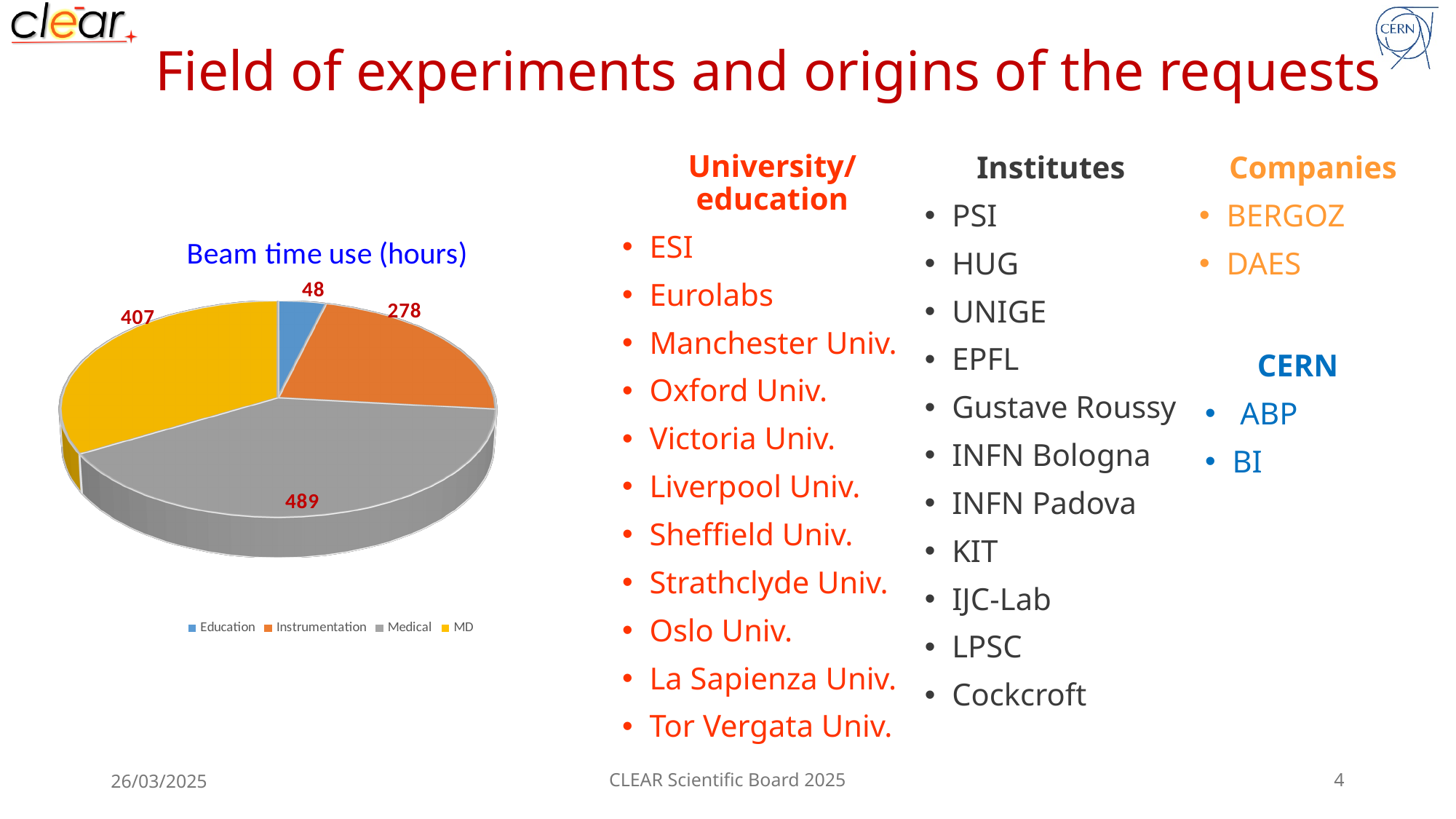
What kind of chart is shown on the slide? Pie chart How many hours of beam time are shown for MD? 407 Which category has the smallest share of beam time? Education Which category has the largest share of beam time? Medical Which has more beam time hours, Instrumentation or MD? MD How many hours of beam time are shown for Education? 48 What is the difference in hours between Medical and MD? 82 What is the total number of beam time hours across all four categories? 1222 How many hours of beam time are shown for Medical? 489 How many hours of beam time are shown for Instrumentation? 278 What is the title of the chart? Beam time use (hours) How many categories does the pie chart show? 4